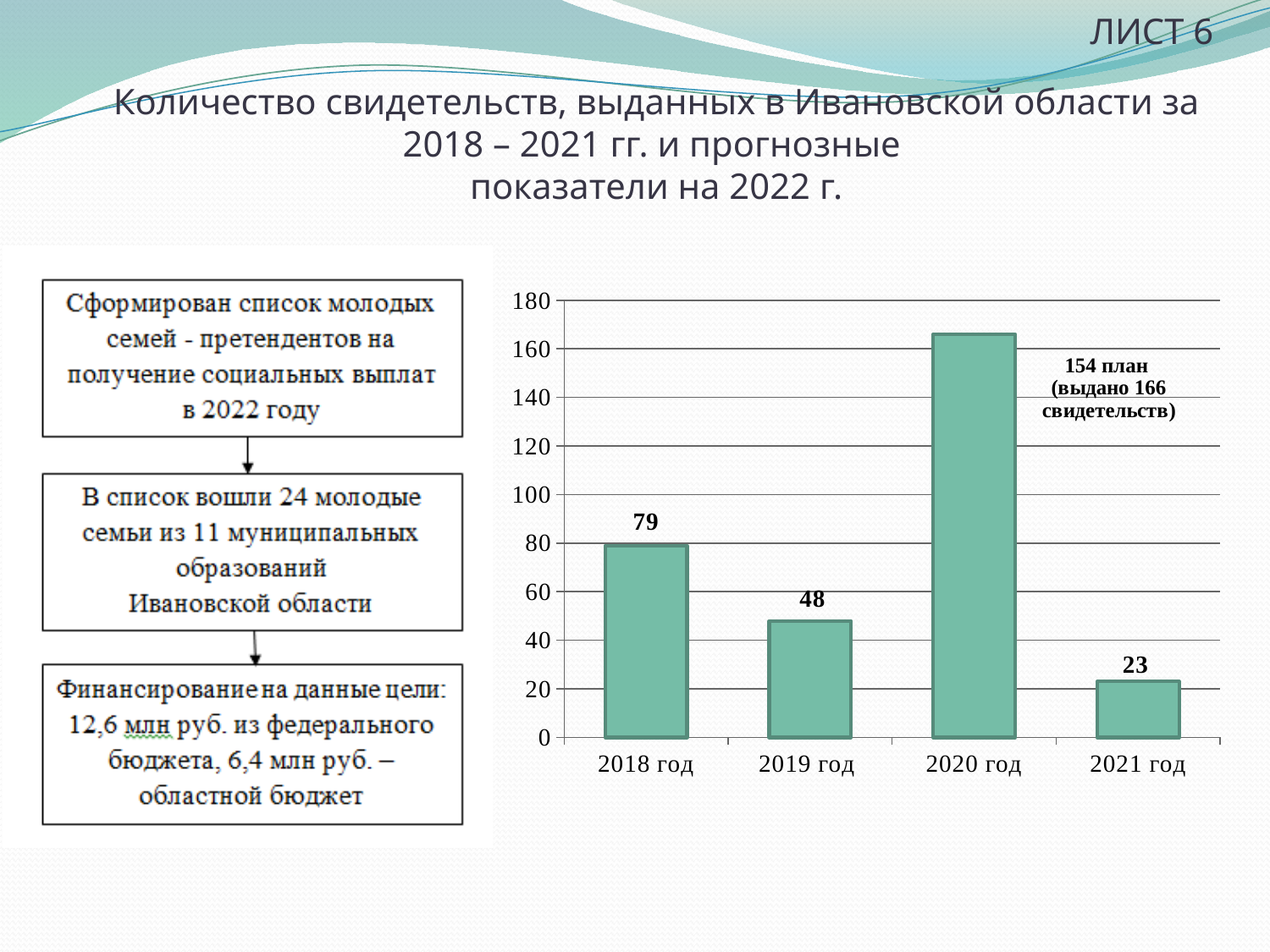
What type of chart is shown on the slide? bar chart What is the value for 2018 год? 79 Which year has the highest bar in the chart? 2020 год Which year has the lowest bar in the chart? 2021 год What is the difference between the values for 2018 год and 2019 год? 31 According to the label on the 2020 год bar, what was the planned (план) number? 154 According to the label on the 2020 год bar, how many certificates were actually issued (выдано)? 166 How many categories (years) are shown on the x axis of the chart? 4 What is the value for 2021 год? 23 Is the bar for 2020 год greater or less than 160? greater What is the value for 2019 год? 48 Which is larger, the value for 2019 год or the value for 2021 год? 2019 год